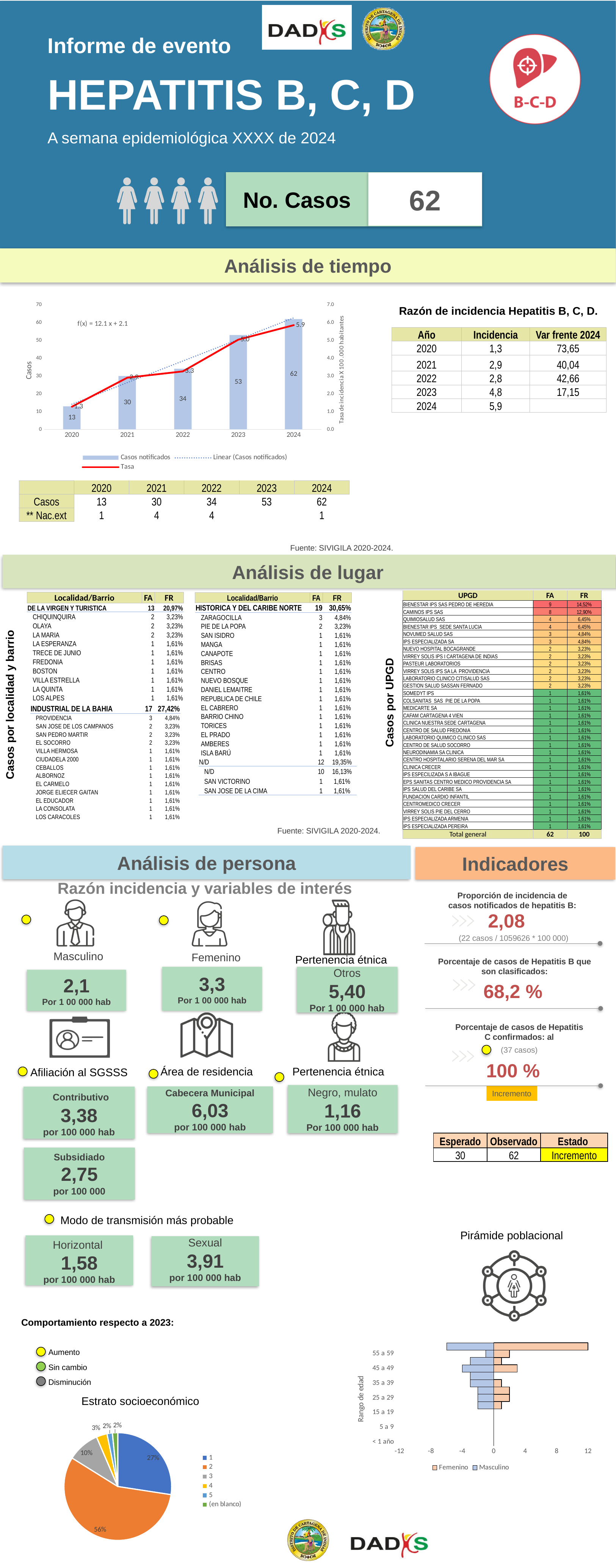
In the 'Análisis de tiempo' chart, what is the Tasa value for 2020? 1.3 In the 'Análisis de tiempo' chart, how many notified cases (Casos notificados) are shown for 2024? 62 In the 'Análisis de tiempo' chart, what is the difference in notified cases between 2023 and 2022? 19 In the 'Estrato socioeconómico' pie chart, what share does estrato 2 have? 56% What kind of chart is the 'Pirámide poblacional' chart? bar chart In the 'Análisis de tiempo' chart, what is the trendline equation shown? f(x) = 12.1 x + 2.1 In the 'Análisis de tiempo' chart, which year has the lowest number of notified cases? 2020 In the 'Análisis de tiempo' chart, which year has the highest number of notified cases? 2024 In the 'Análisis de tiempo' chart, how many series does the legend list? 3 In the 'Estrato socioeconómico' pie chart, which estrato has the largest share? 2 In the 'Análisis de tiempo' chart, do the notified cases rise or fall from 2020 to 2024? rise In the 'Estrato socioeconómico' pie chart, how many entries does the legend list? 6